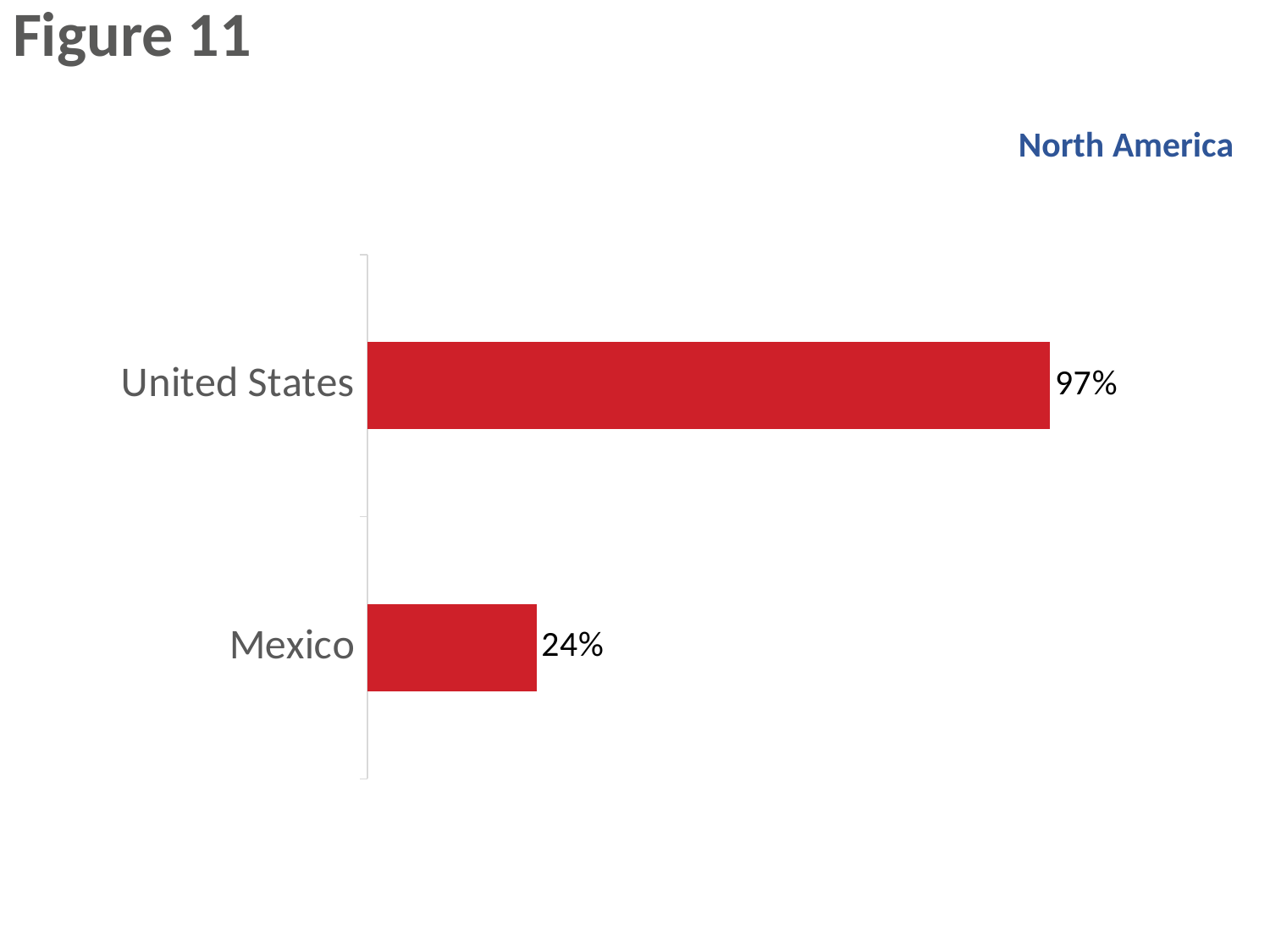
What is the value for United States? 97% How many categories are shown in the chart? 2 Which is larger, the value for United States or the value for Mexico? United States Which category has the lowest value? Mexico What is the value for Mexico? 24% Which category has the highest value? United States What kind of chart is shown on the slide? Bar chart What region label appears above the chart? North America What colour are the bars in the chart? Red What is the difference between the values for United States and Mexico? 73%